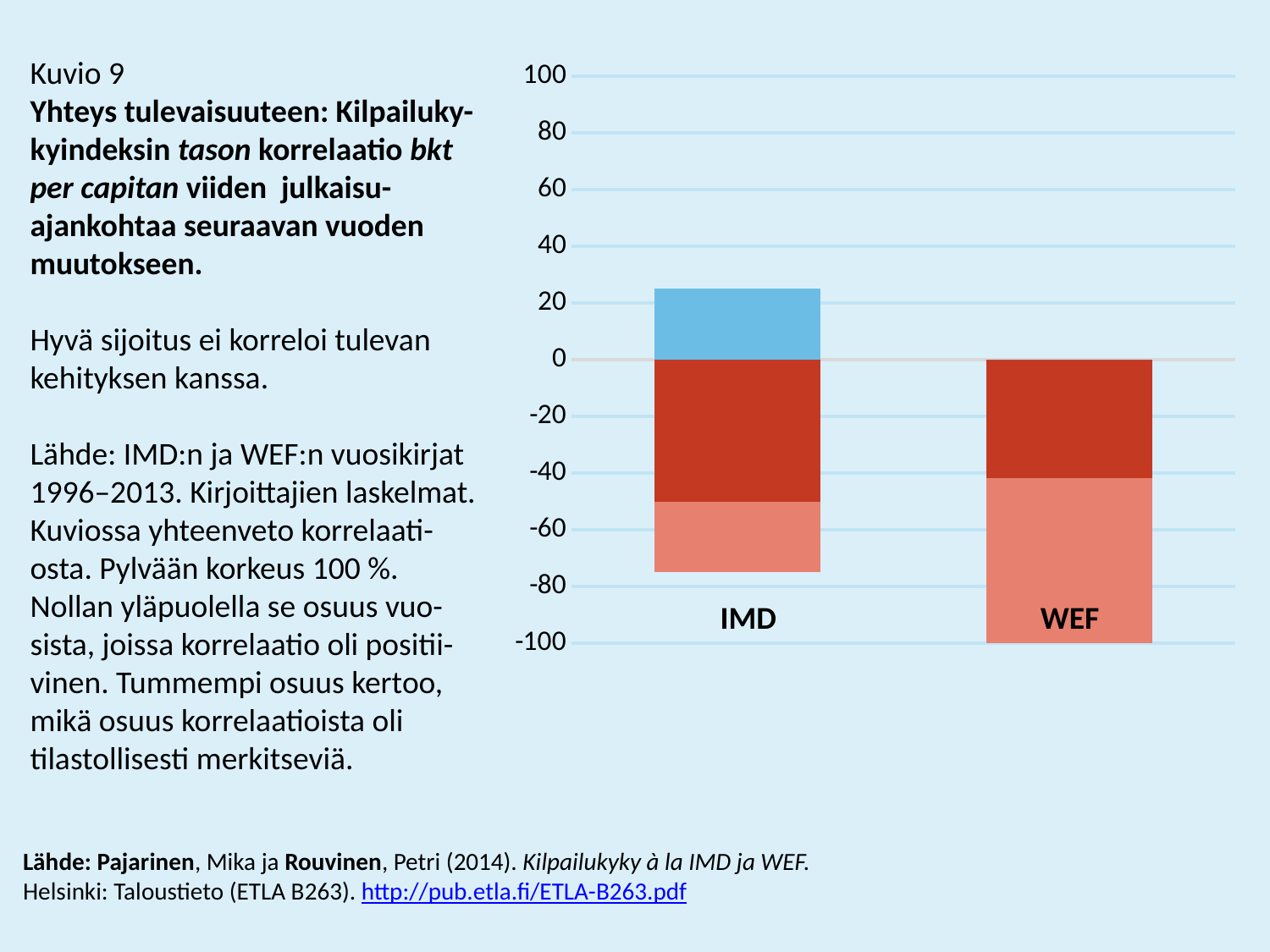
How many categories are shown on the x axis of the chart? 2 Is the boundary between the dark red and light red segments of the WEF bar greater or less than -20? less Is the top of the IMD bar greater or less than 40? less What kind of chart is shown on the slide? Stacked bar chart Which category's bar extends further below zero, IMD or WEF? WEF Which category has a segment above zero? IMD Is the boundary between the dark red and light red segments of the IMD bar greater or less than -40? less Does the WEF bar have any segment above zero? No What value does the bottom of the WEF bar reach on the y axis? -100 What is the highest value shown on the y axis? 100 What are the two categories shown on the x axis? IMD and WEF